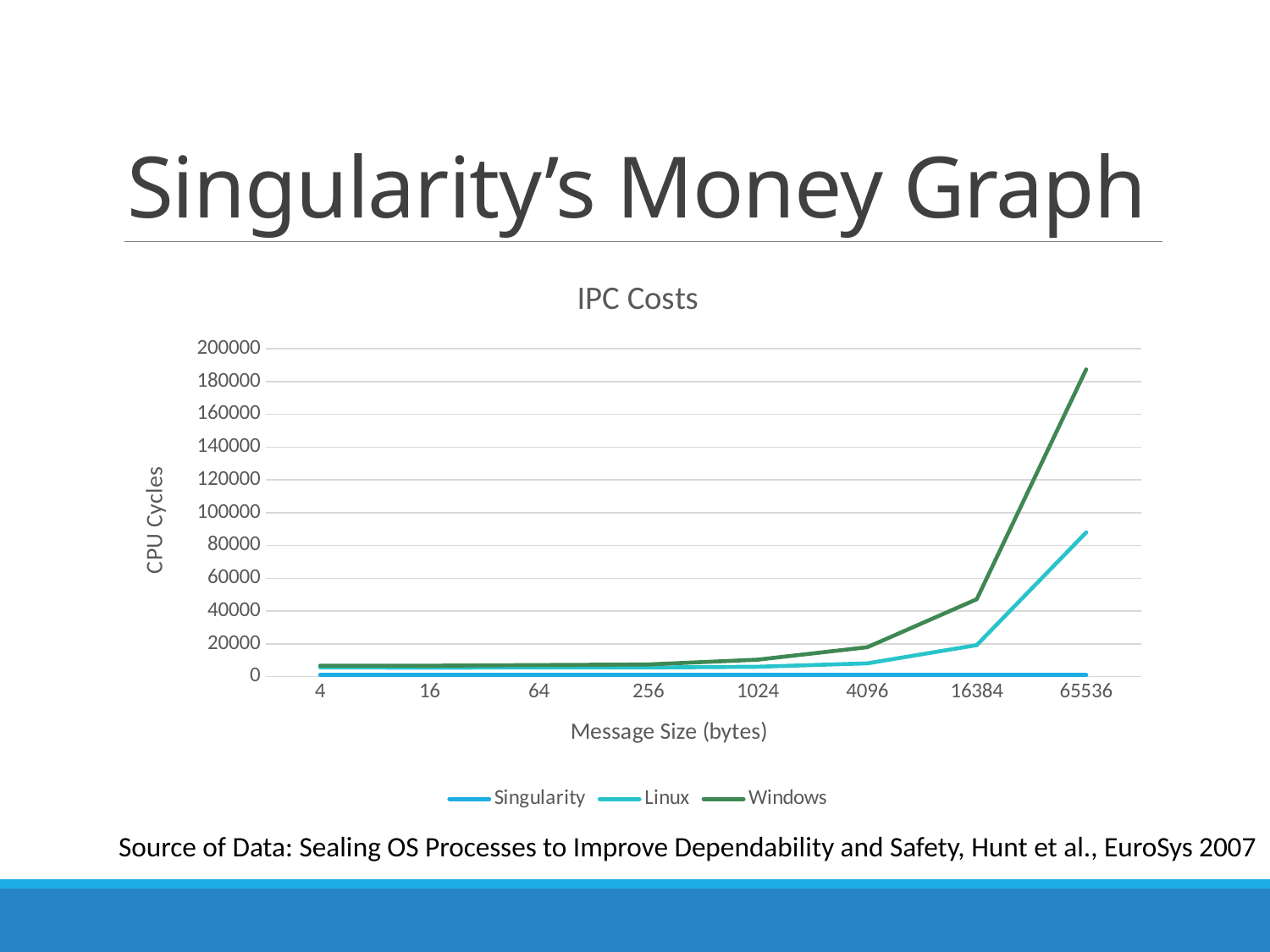
At 65536 bytes, which is larger: the value for Windows or the value for Linux? Windows Is the value for Windows at 65536 bytes greater or less than 160000? greater How many series does the legend list? 3 Is the value for Windows at 16384 bytes greater or less than 60000? less Which series has the highest CPU cycles at a message size of 65536 bytes? Windows What kind of chart is shown on the slide? line chart Is the value for Linux at 65536 bytes greater or less than 100000? less Do the CPU cycles for Windows rise or fall as message size increases? rise How many message sizes are plotted along the x axis? 8 Which series has the lowest CPU cycles at a message size of 65536 bytes? Singularity What is the title of the chart? IPC Costs